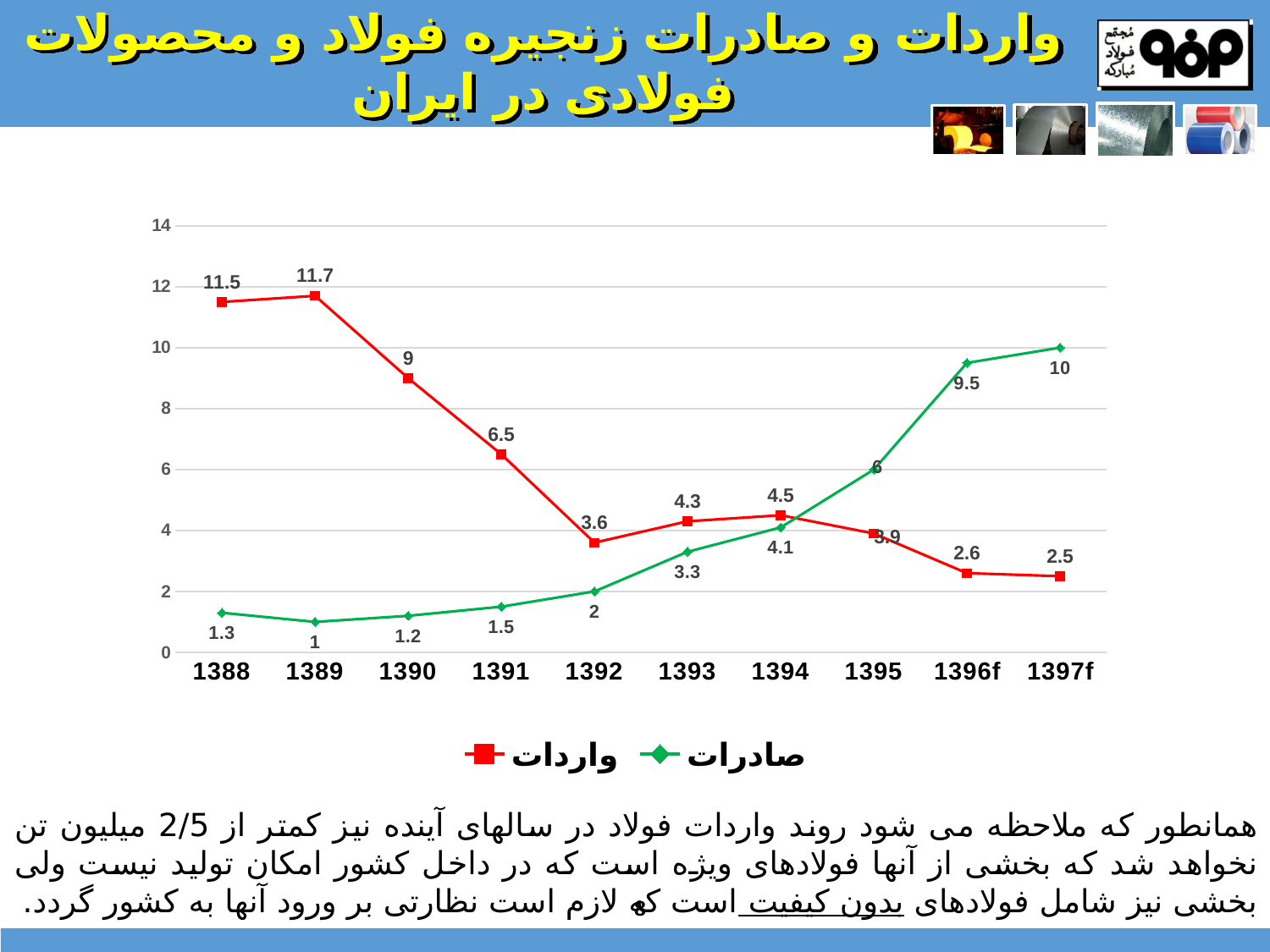
In which year is صادرات (exports) highest? 1397f What is the value of صادرات (exports) in 1396f? 9.5 In which year is واردات (imports) lowest? 1397f In which year is صادرات (exports) lowest? 1389 How many years are shown on the x axis? 10 What type of chart is shown on the slide? line chart What is the value of واردات (imports) in 1392? 3.6 What is the value of واردات (imports) in 1389? 11.7 Does صادرات (exports) generally rise or fall from 1388 to 1397f? rise Which is larger in 1395, واردات (imports) or صادرات (exports)? صادرات (exports) What is the difference between واردات (imports) and صادرات (exports) in 1388? 10.2 How many series does the legend list? 2